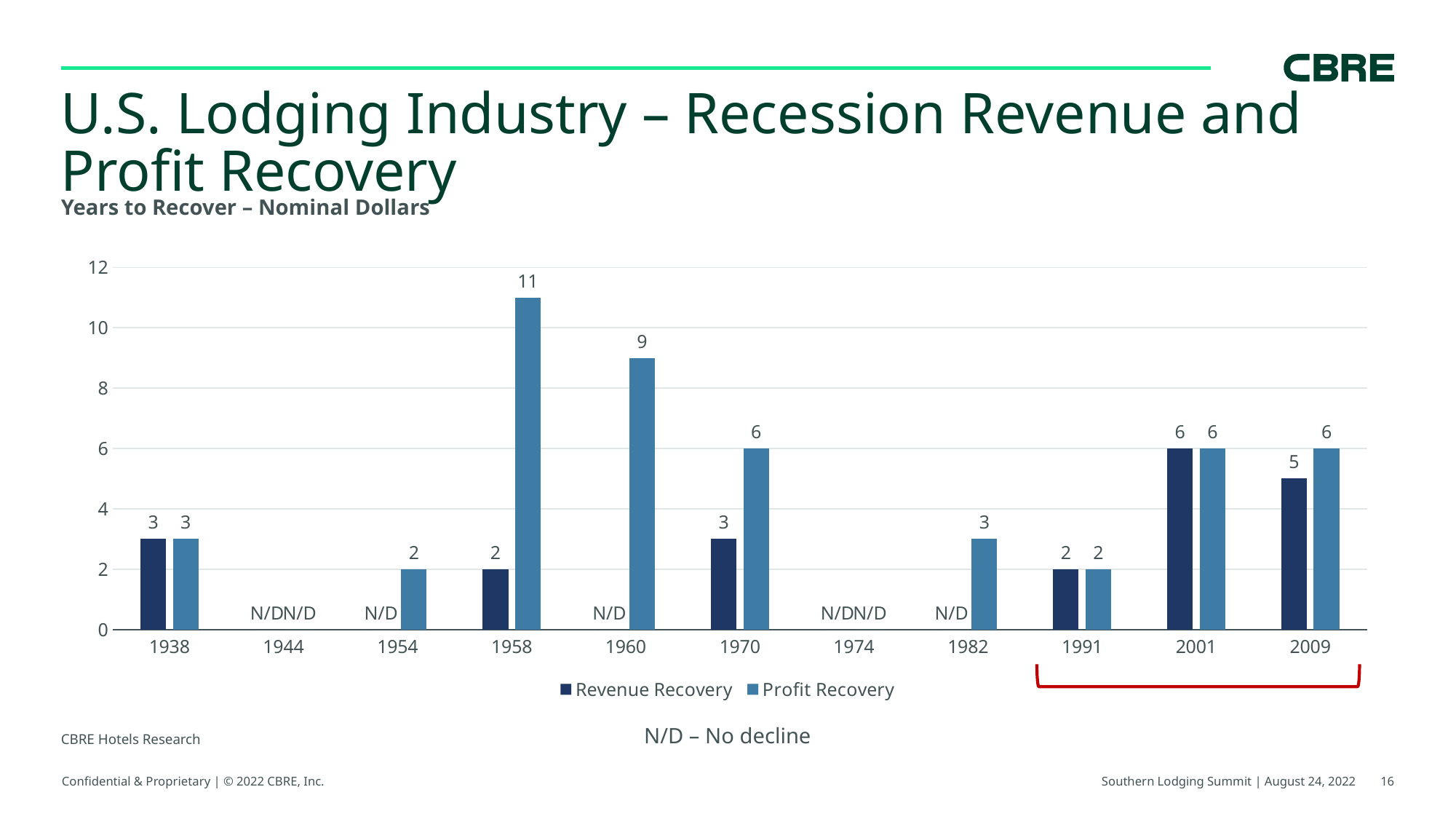
What is the Revenue Recovery value for 2009? 5 How many series does the legend list? 2 Which year has the highest Revenue Recovery value? 2001 What is the Profit Recovery value for 1958? 11 Which year has the highest Profit Recovery value? 1958 What is shown for Revenue Recovery in 1944? N/D What kind of chart is shown on the slide? Bar chart How many years are shown on the x axis? 11 Which is larger, the Profit Recovery value for 1960 or for 1970? 1960 What does N/D stand for according to the note below the chart? No decline What is the Profit Recovery value for 1982? 3 What is the difference between the Profit Recovery and Revenue Recovery values for 1970? 3